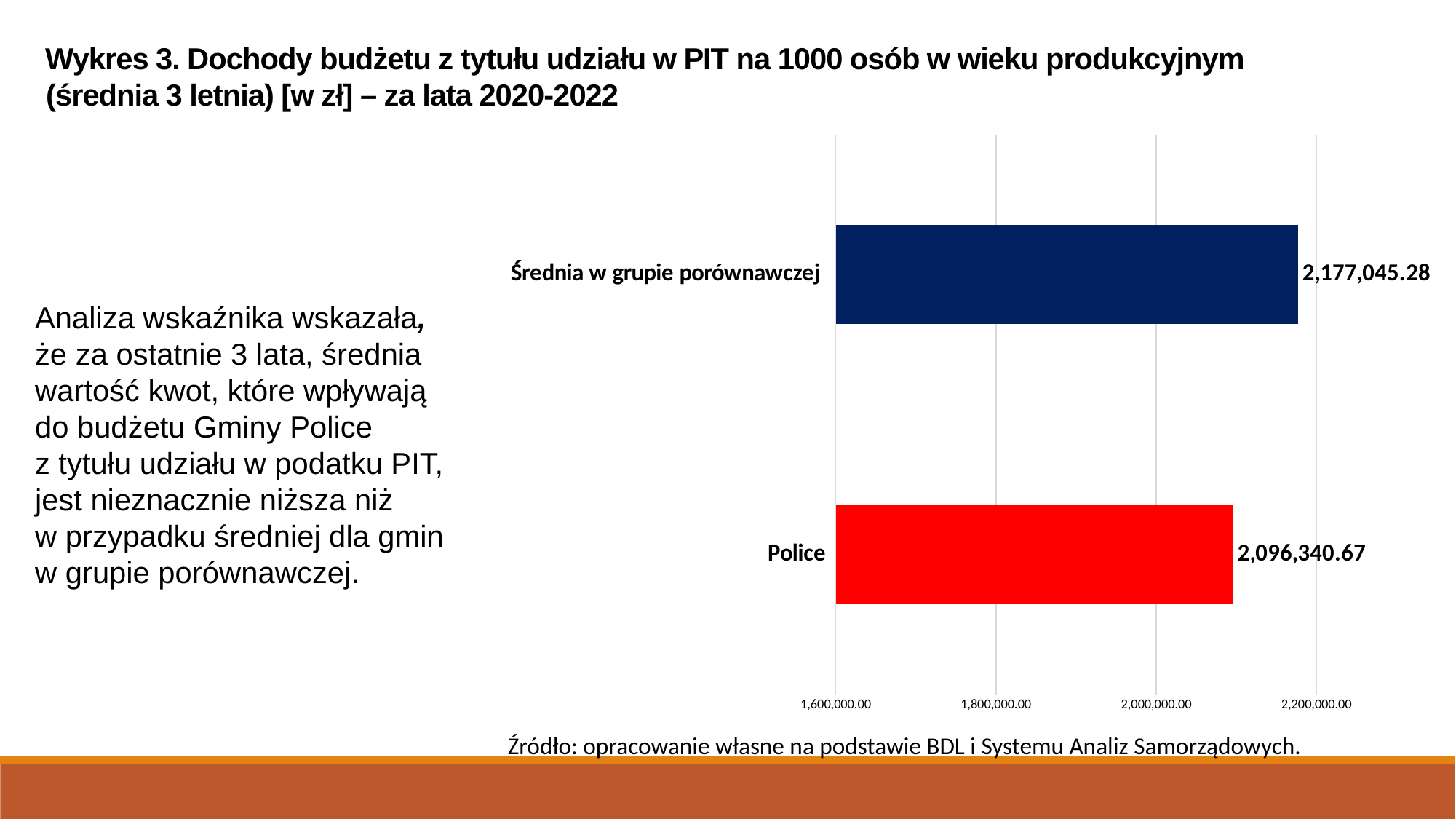
Which category has the highest value? Średnia w grupie porównawczej Which is larger, the value for Police or the value for Średnia w grupie porównawczej? Średnia w grupie porównawczej Is the value for Średnia w grupie porównawczej greater or less than 2,200,000.00? less Is the value for Police greater or less than 2,000,000.00? greater What kind of chart is shown on the slide? bar chart What colour is the bar for Police? red What is the difference between the value for Średnia w grupie porównawczej and the value for Police? 80,704.61 What is the value for Police? 2,096,340.67 What is the value for Średnia w grupie porównawczej? 2,177,045.28 How many categories are shown in the chart? 2 What is the lowest value shown on the horizontal axis? 1,600,000.00 Which category has the lowest value? Police